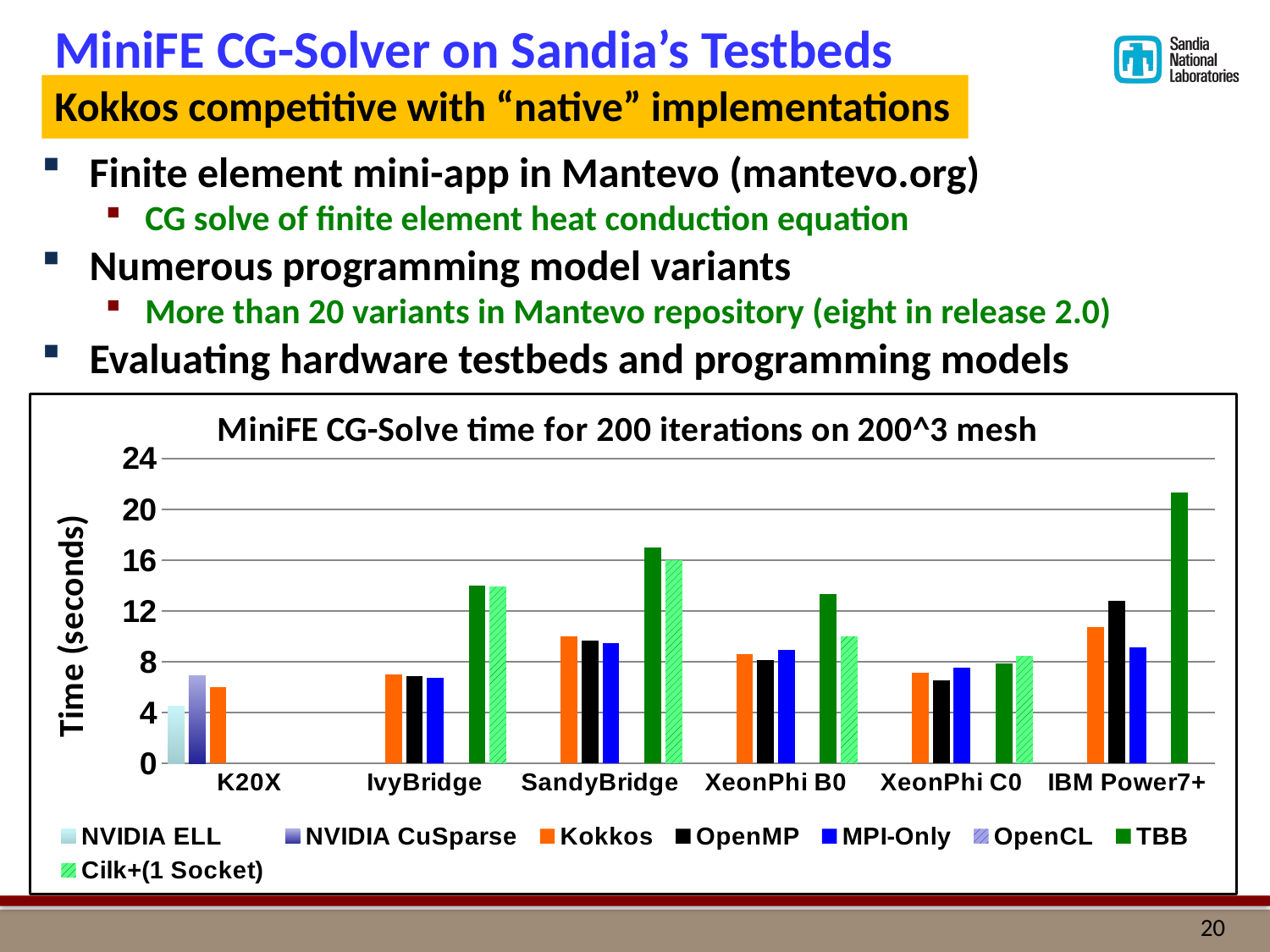
Is the TBB value for SandyBridge greater or less than 16? greater How many series does the chart's legend list? 8 What kind of chart is shown on the slide? bar chart What is the label of the vertical axis of the chart? Time (seconds) What is the title of the chart? MiniFE CG-Solve time for 200 iterations on 200^3 mesh Which testbed has the highest TBB time in the chart? IBM Power7+ On IBM Power7+, which is larger: the OpenMP time or the MPI-Only time? OpenMP Is the TBB value for IBM Power7+ greater or less than 20? greater Is the Kokkos value for K20X greater or less than 8? less Which series has the lowest time on the K20X testbed? NVIDIA ELL On SandyBridge, which is larger: the TBB time or the Kokkos time? TBB How many hardware testbeds (categories) are shown on the x axis of the chart? 6